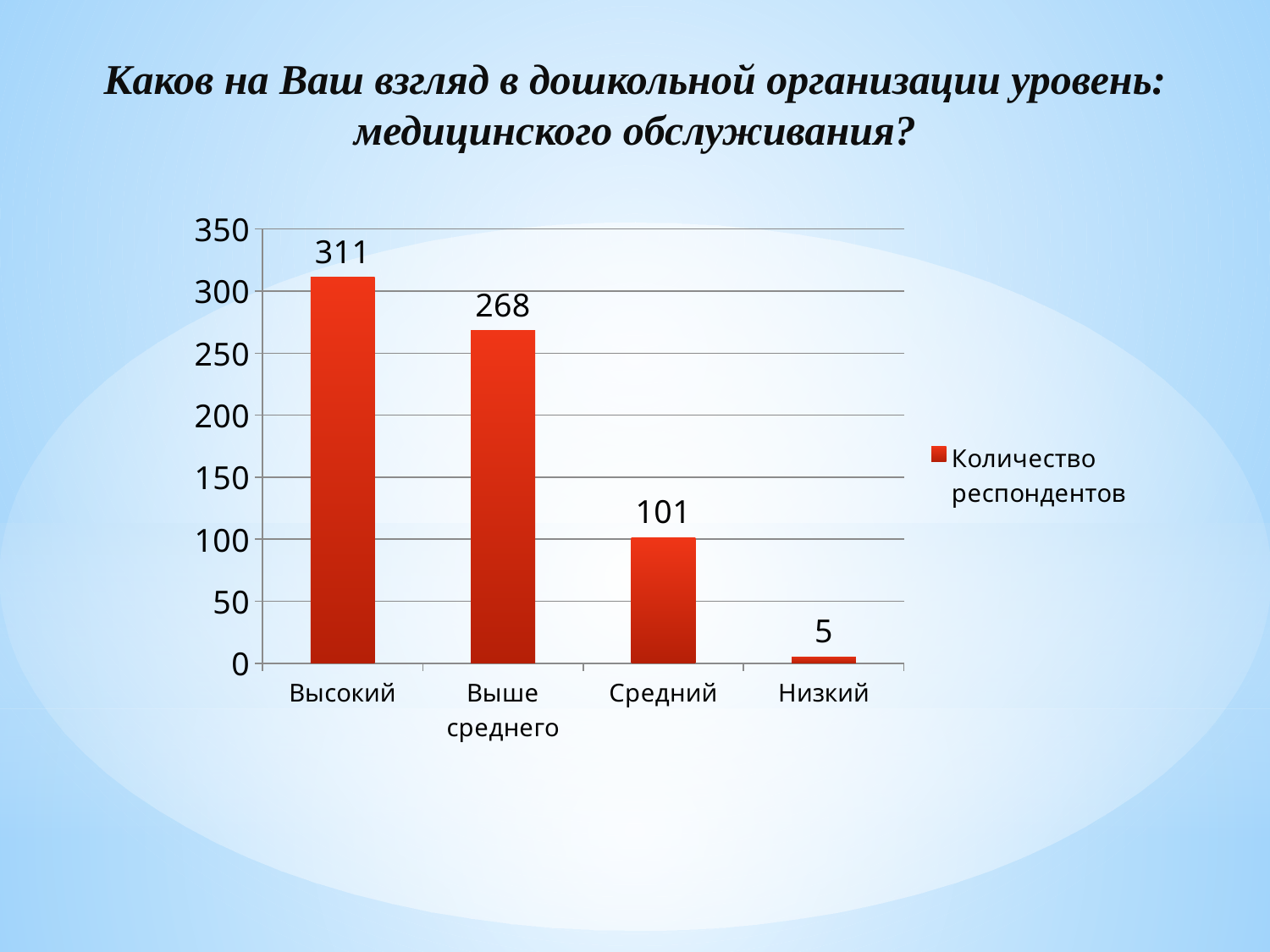
What series name does the legend show? Количество респондентов What kind of chart is shown on the slide? bar chart What is the value for Низкий? 5 What is the value for Средний? 101 What is the difference between the values for Средний and Низкий? 96 Which category has the lowest value? Низкий What is the difference between the values for Высокий and Выше среднего? 43 What is the value for Выше среднего? 268 How many categories are shown on the x axis? 4 What is the value for Высокий? 311 Which is larger, the value for Выше среднего or the value for Средний? Выше среднего Which category has the highest value? Высокий